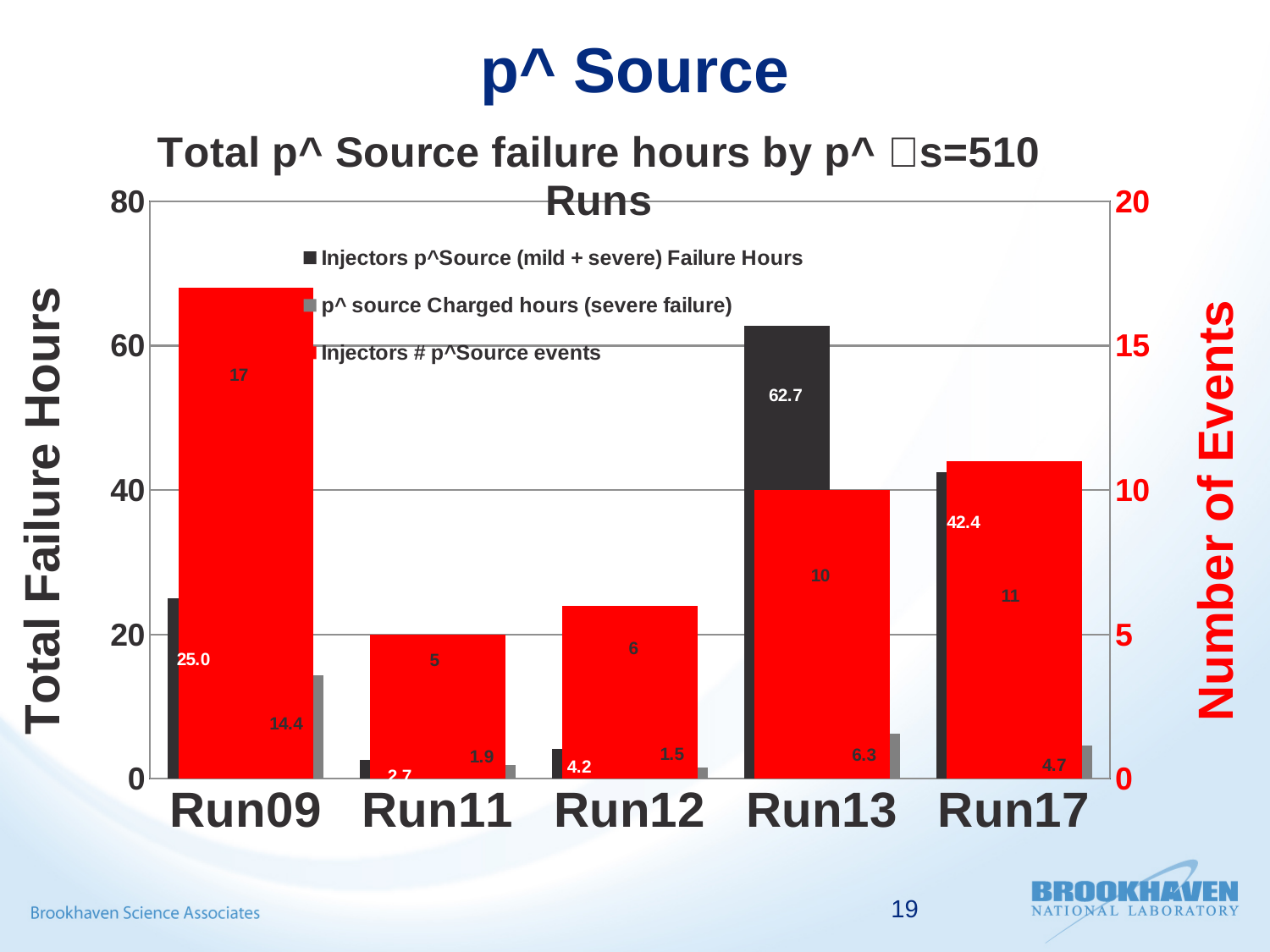
Which run has the lowest number of Injectors # p^Source events? Run11 What is the difference in Injectors p^Source (mild + severe) Failure Hours between Run13 and Run17? 20.3 Is the Injectors p^Source (mild + severe) Failure Hours value for Run09 greater or less than 20? greater Which run has the highest Injectors p^Source (mild + severe) Failure Hours? Run13 Which is larger, the p^ source Charged hours (severe failure) for Run13 or for Run17? Run13 What is the Injectors p^Source (mild + severe) Failure Hours value for Run13? 62.7 How many Injectors # p^Source events are shown for Run17? 11 What is the p^ source Charged hours (severe failure) value for Run09? 14.4 How many series does the legend list? 3 What kind of chart is shown on the slide? bar chart How many runs are shown on the x axis? 5 What is the label of the right-hand vertical axis? Number of Events